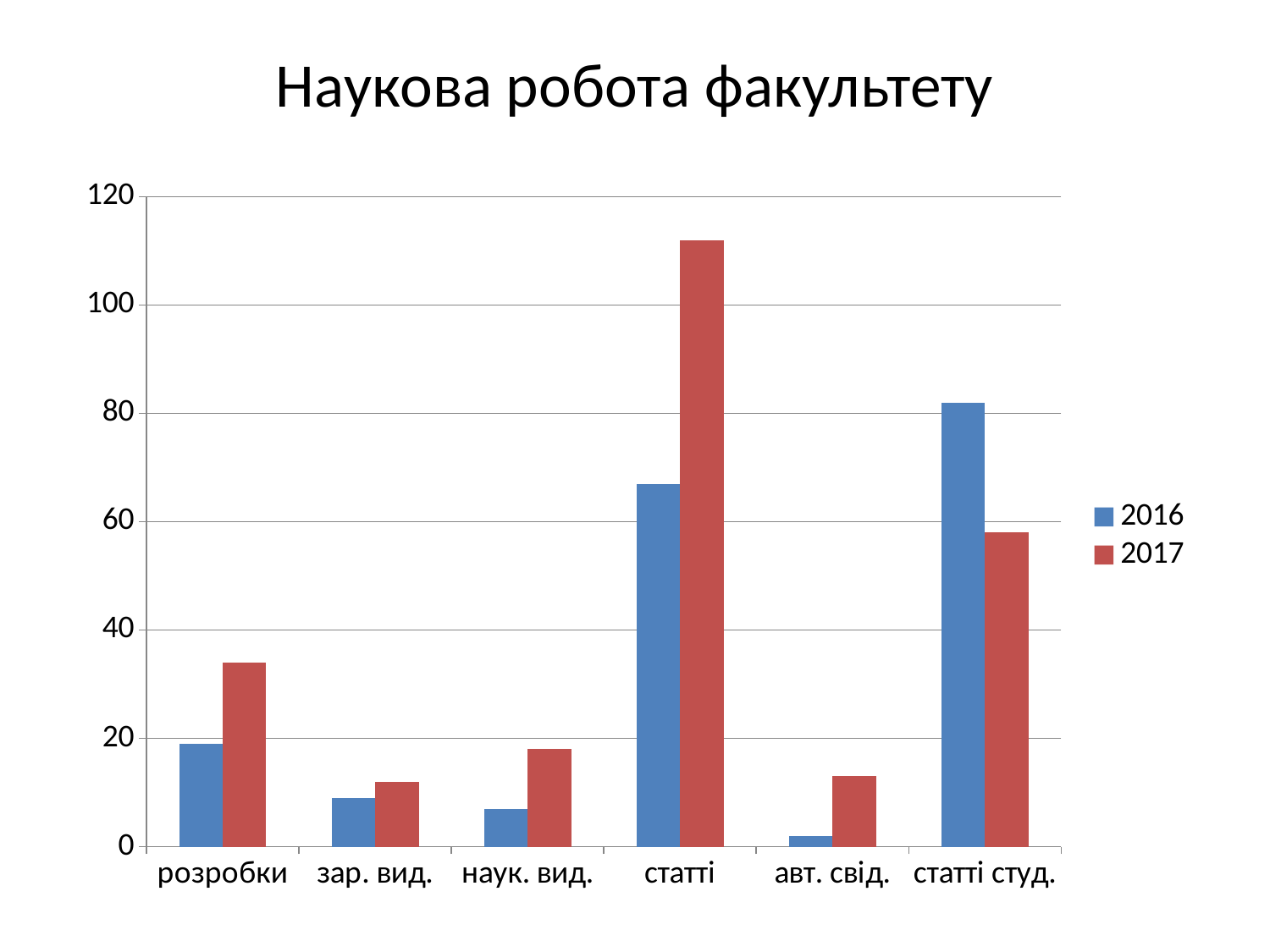
Which category has the highest value for 2016? статті студ. Is the 2017 value for статті greater or less than 100? greater How many series does the legend list? 2 How many categories are shown on the x axis? 6 Is the 2016 value for статті greater or less than 60? greater Is the 2017 value for розробки greater or less than 40? less For статті студ., which year has the larger value, 2016 or 2017? 2016 Which category has the lowest value for 2016? авт. свід. What kind of chart is shown on the slide? bar chart What is the title of the chart? Наукова робота факультету Which category has the highest value for 2017? статті For статті, which year has the larger value, 2016 or 2017? 2017